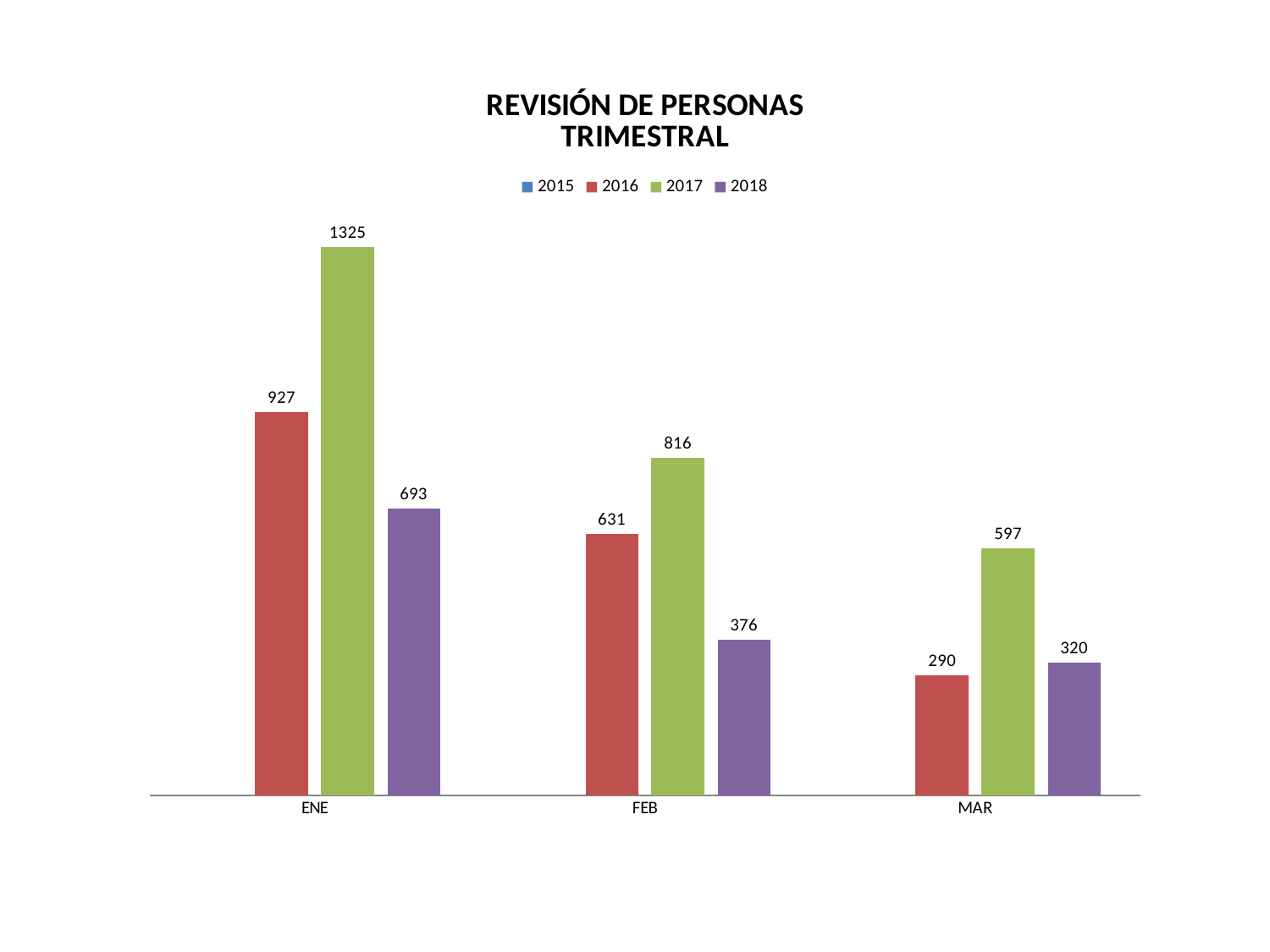
What is the difference between the 2017 and 2016 values in ENE? 398 Do the values for 2017 rise or fall from ENE to MAR? Fall What kind of chart is shown on the slide? Bar chart How many series does the legend list? 4 What is the value for 2018 in MAR? 320 Which is larger in MAR, the value for 2016 or the value for 2018? 2018 Which month has the highest value for 2017? ENE What is the difference between the 2018 values in ENE and FEB? 317 Which month has the lowest value for 2016? MAR What is the value for 2016 in FEB? 631 How many months are shown on the x axis? 3 What is the value for 2017 in ENE? 1325